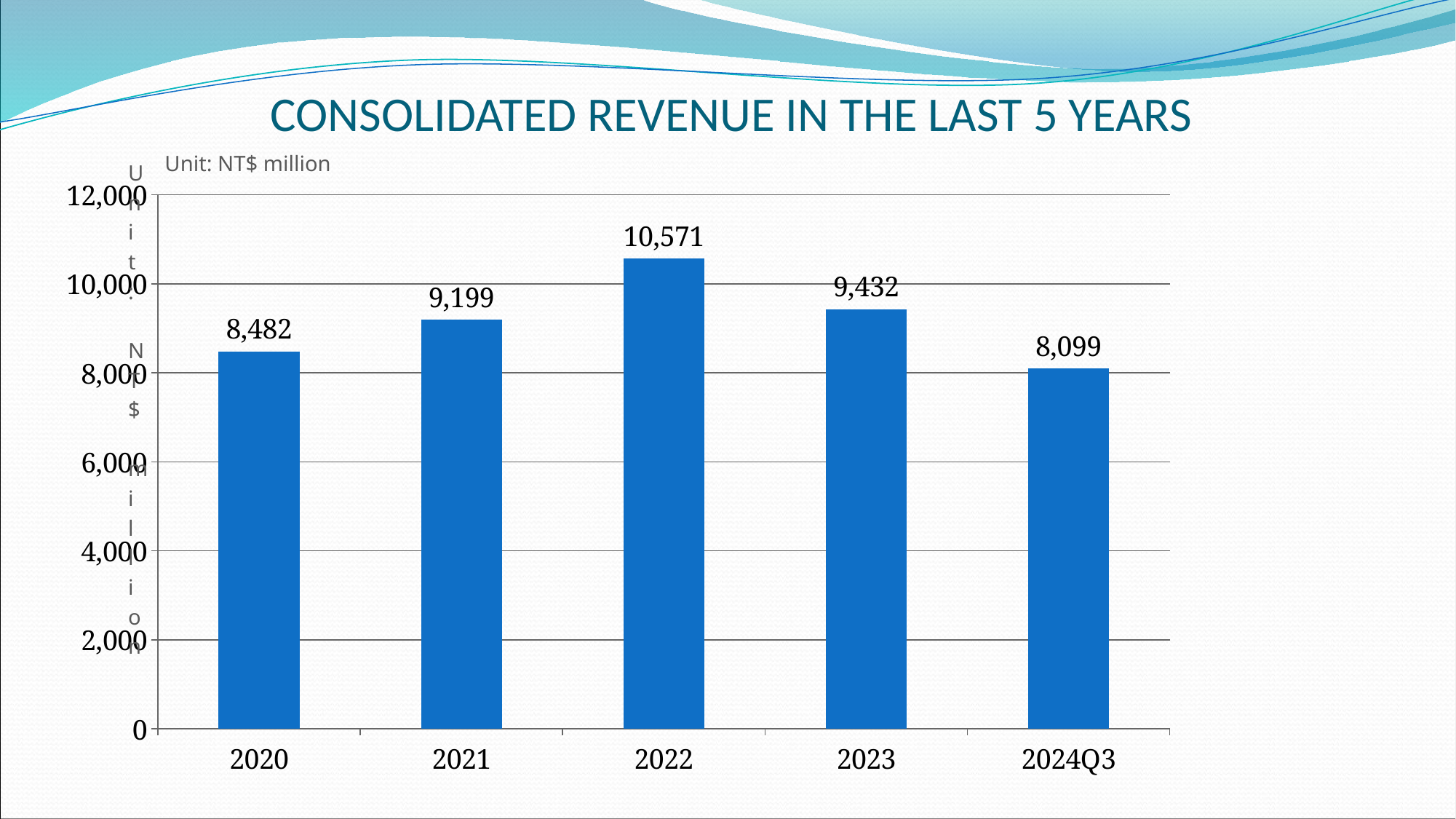
What is the consolidated revenue for 2024Q3? 8,099 What is the difference in consolidated revenue between 2021 and 2020? 717 Which year has the highest consolidated revenue? 2022 What is the difference in consolidated revenue between 2022 and 2023? 1,139 What unit is the consolidated revenue expressed in? NT$ million Is the consolidated revenue for 2022 greater or less than 10,000? greater What is the consolidated revenue for 2020? 8,482 What kind of chart is shown on the slide? bar chart Which period has the lowest consolidated revenue? 2024Q3 Which is larger, the consolidated revenue for 2021 or for 2023? 2023 What is the consolidated revenue for 2022? 10,571 How many periods are shown on the x axis of the chart? 5